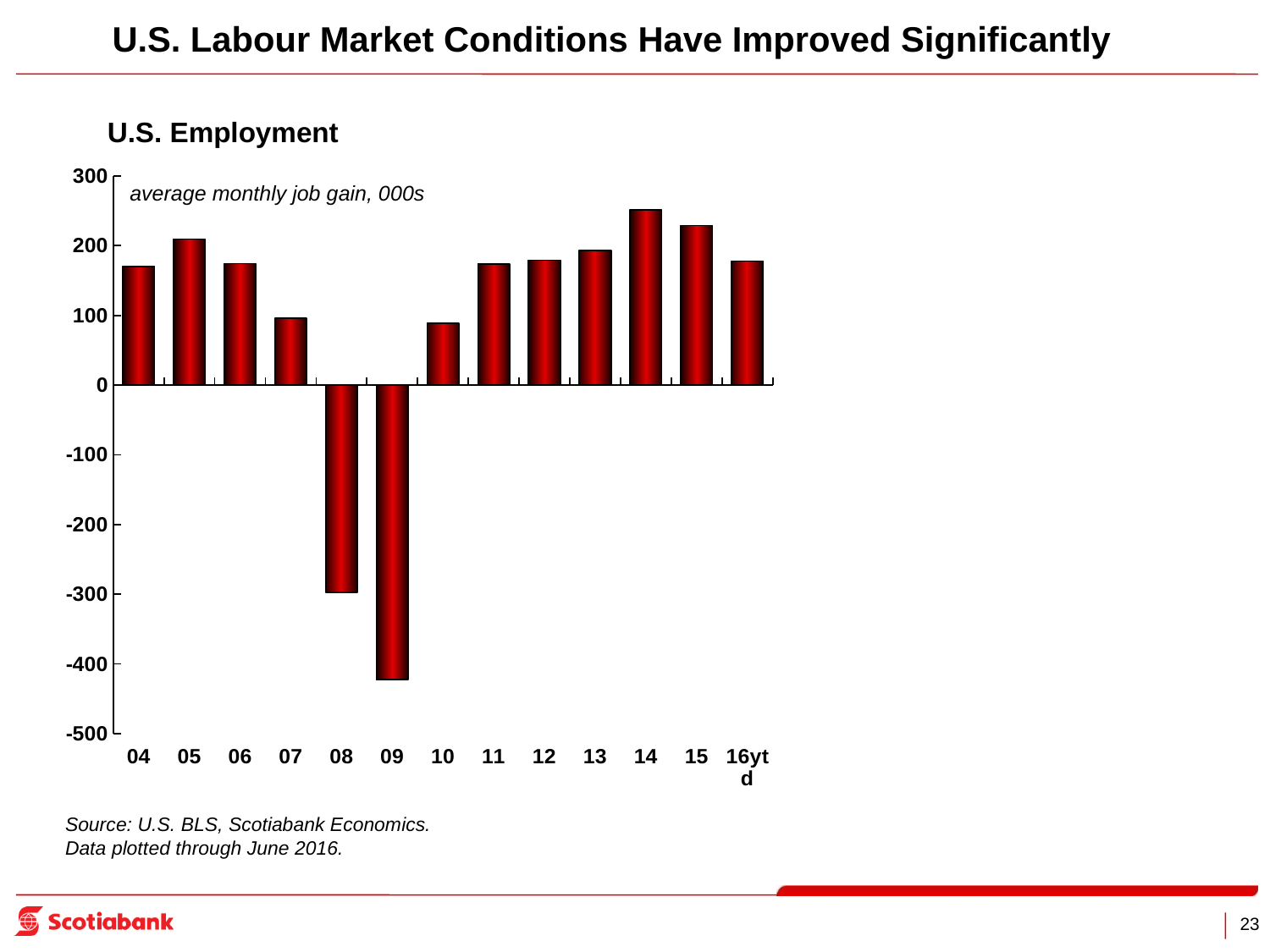
How many years (categories) are plotted on the x axis of the U.S. Employment chart? 13 Is the value for 09 greater or less than -400? less Which year has the highest average monthly job gain in the U.S. Employment chart? 14 What unit does the chart's subtitle say the values are in? 000s Which year has the lowest value in the U.S. Employment chart? 09 Do the values rise or fall from 09 to 14? rise Which is larger, the value for 14 or the value for 15? 14 Which is larger, the value for 05 or the value for 07? 05 Is the value for 14 greater or less than 200? greater Is the value for 08 greater or less than -200? less What kind of chart is shown on the slide? bar chart